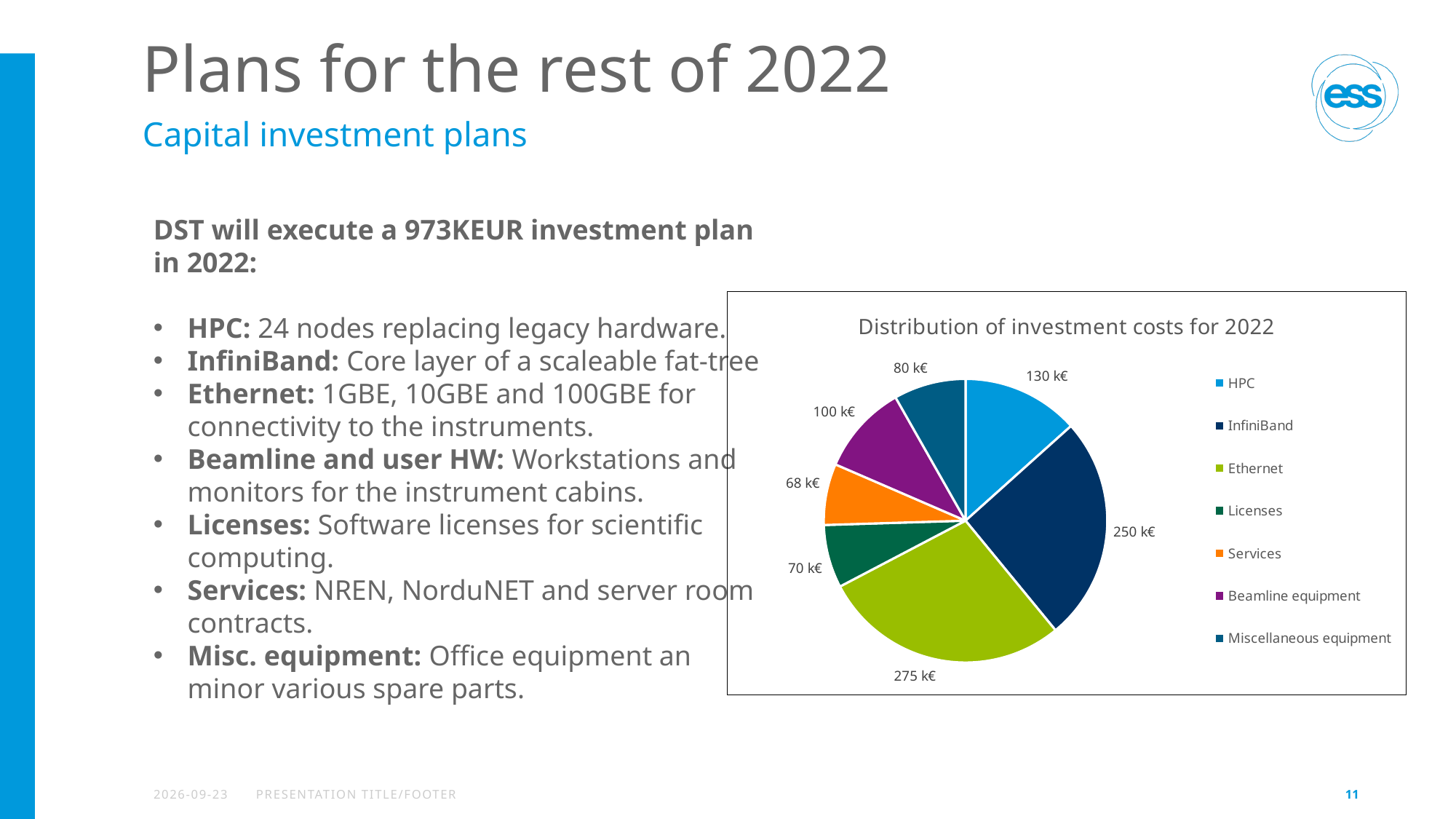
What is the title of the chart? Distribution of investment costs for 2022 How many categories does the legend of the pie chart list? 7 What is the difference between the investment costs for Ethernet and InfiniBand? 25 k€ Which category has the smallest investment cost? Services Which category has the largest investment cost? Ethernet What is the investment cost for Ethernet? 275 k€ Which has a larger investment cost, Beamline equipment or Licenses? Beamline equipment What is the investment cost for InfiniBand? 250 k€ What is the difference between the investment costs for HPC and Miscellaneous equipment? 50 k€ What is the total of all the investment costs shown in the pie chart? 973 k€ What type of chart is shown on the slide? pie chart What is the investment cost for Services? 68 k€